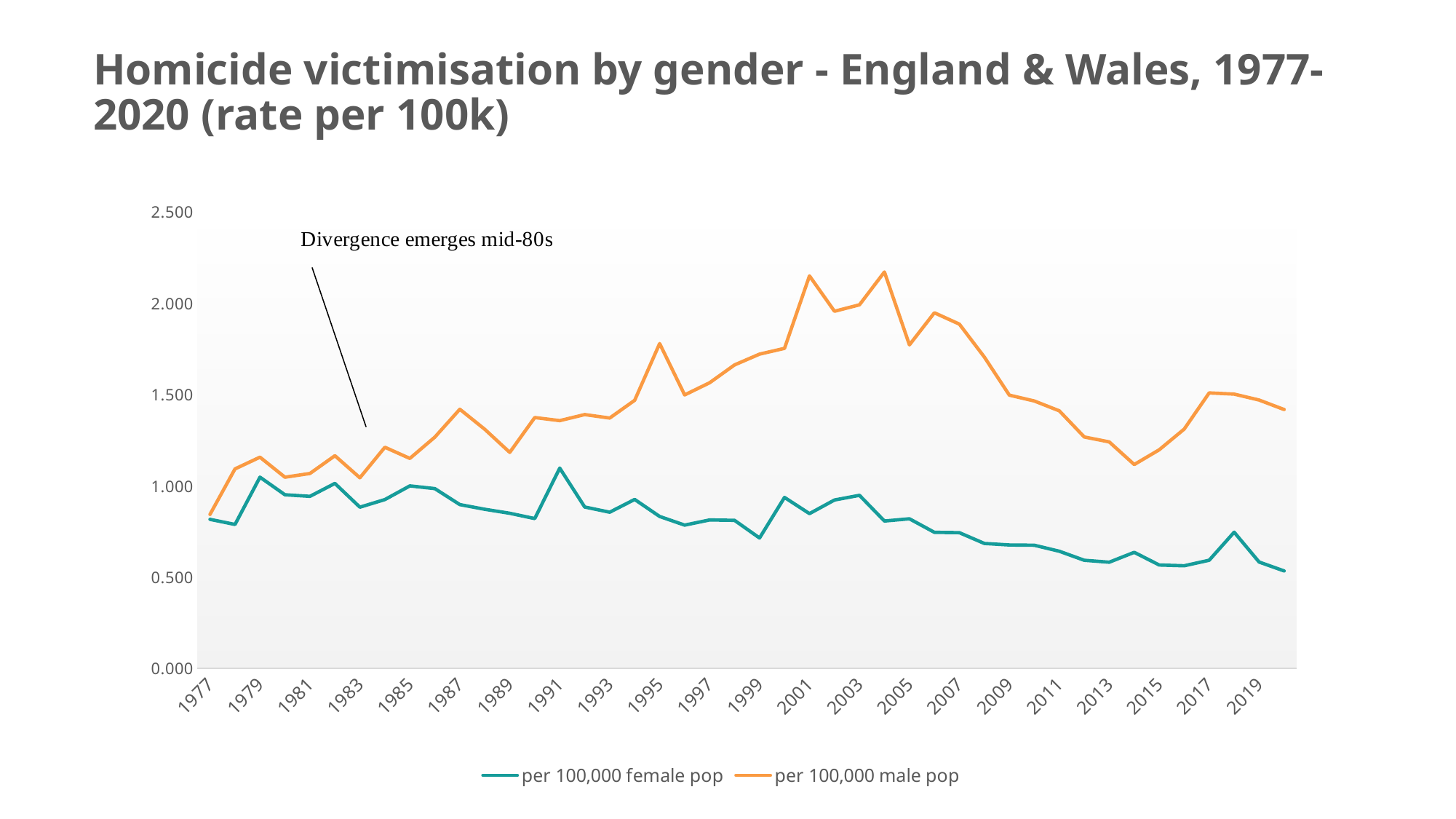
Is the value for per 100,000 female pop in 1999 greater or less than 1.000? less What kind of chart is shown on the slide? line chart In 2010, which series has the larger value, per 100,000 male pop or per 100,000 female pop? per 100,000 male pop What are the two series named in the legend? per 100,000 female pop; per 100,000 male pop How many series does the legend list? 2 Is the value for per 100,000 male pop in 2014 greater or less than 1.500? less What does the annotation on the chart say? Divergence emerges mid-80s How many year labels are shown on the x axis? 22 Is the value for per 100,000 female pop in 2018 greater or less than 0.500? greater Does the per 100,000 female pop line rise or fall between 2003 and 2013? fall